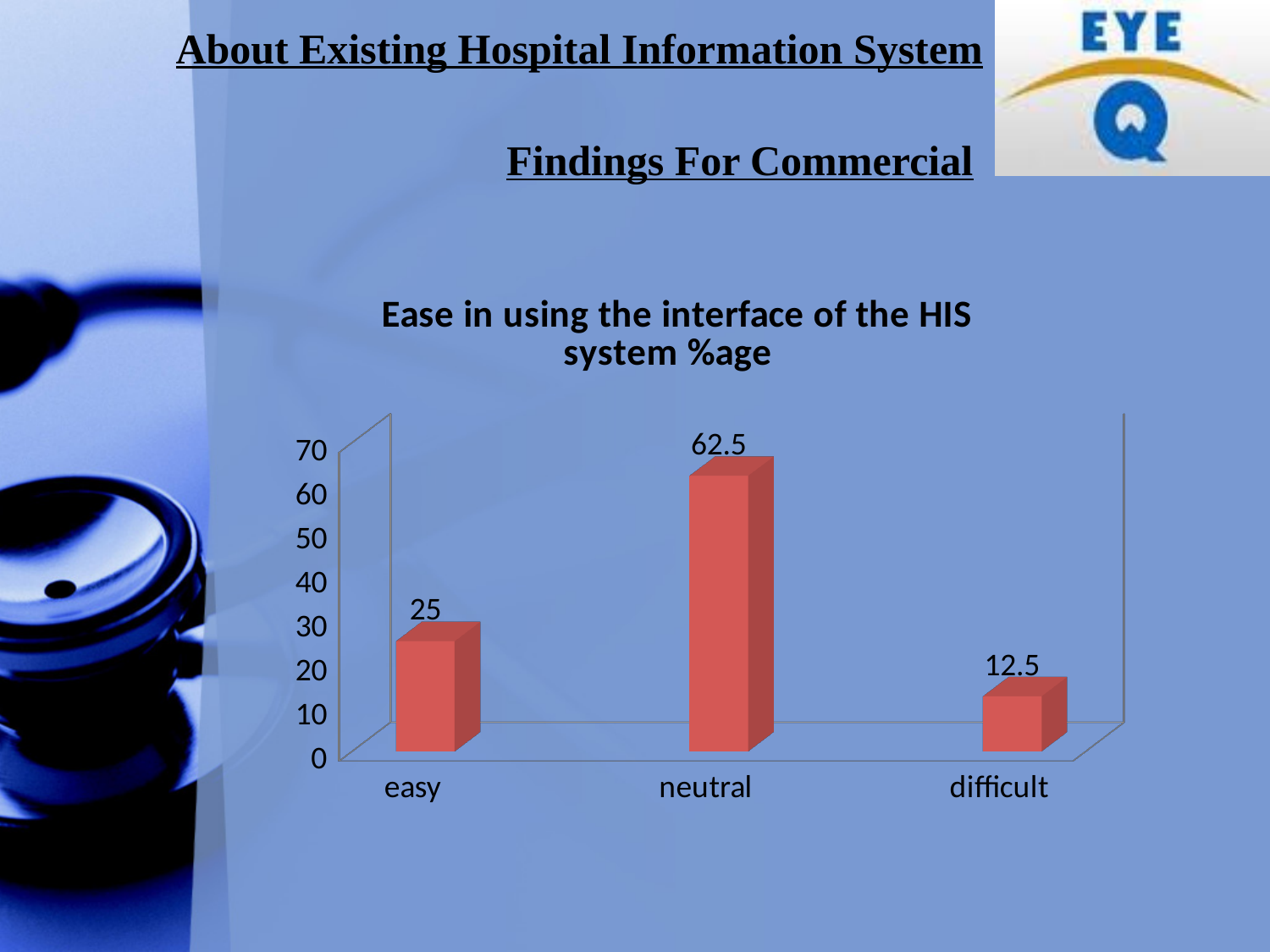
Which is larger, the value for easy or the value for difficult? easy What kind of chart is shown on the slide? bar chart Is the value for neutral greater or less than 50? greater Which category has the highest value? neutral What is the value for easy? 25 How many categories are shown on the x axis? 3 What is the value for difficult? 12.5 What is the title of the chart? Ease in using the interface of the HIS system %age Which category has the lowest value? difficult What is the difference between the values for easy and difficult? 12.5 What is the value for neutral? 62.5 What is the difference between the values for neutral and easy? 37.5